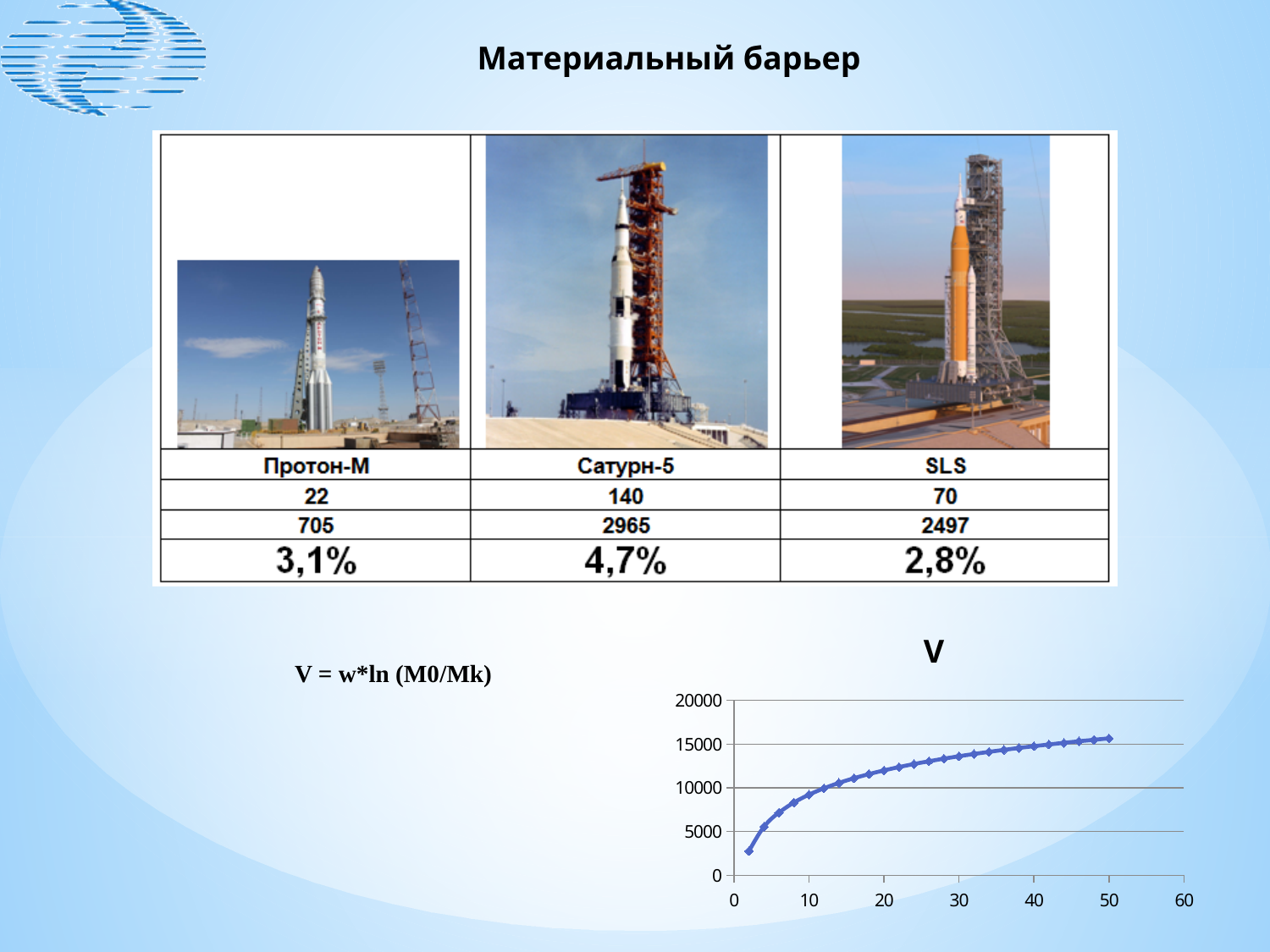
In the chart titled V, do the values rise or fall as the x axis increases? rise What is the highest tick label on the y axis of the chart titled V? 20000 What is the title of the chart at the bottom right of the slide? V In the chart titled V, is the value at the first plotted point (near x = 2) greater or less than 5000? less In the chart titled V, which is larger: the value at x = 10 or the value at x = 40? the value at x = 40 In the chart titled V, is the value at x = 10 greater or less than 10000? less In the chart titled V, is the value at x = 20 greater or less than 15000? less What kind of chart is shown at the bottom right of the slide? line chart